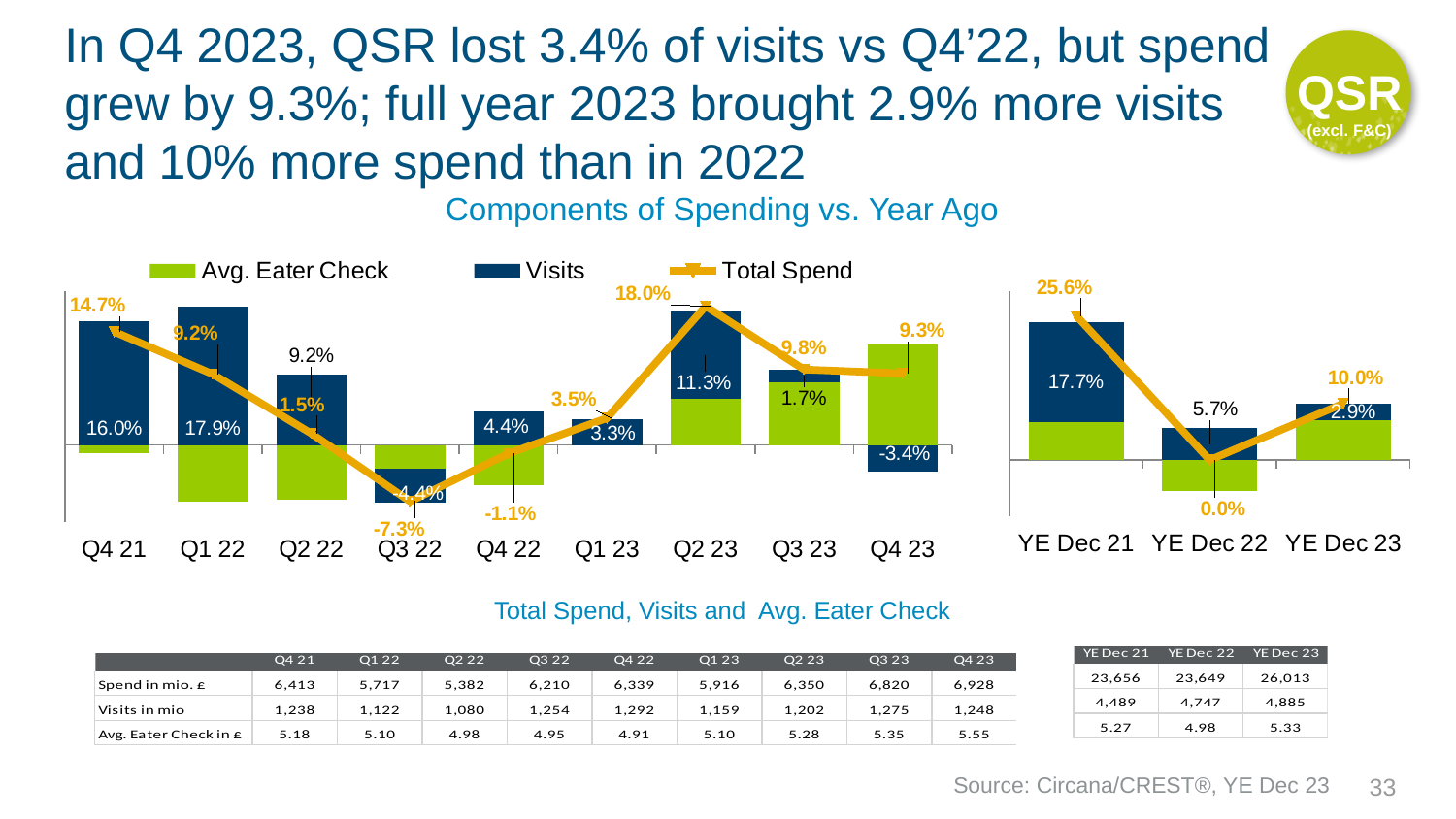
In the quarterly chart on the left, what is the difference between the Total Spend values for Q2 23 and Q3 23? 8.2 percentage points How many series does the legend of the Components of Spending vs. Year Ago chart list? 3 In the yearly chart on the right, what is the Total Spend value for YE Dec 21? 25.6% In the quarterly chart on the left, does the Total Spend line rise or fall from Q3 22 to Q2 23? Rise How many quarters are shown on the x axis of the quarterly chart on the left? 9 In the quarterly chart on the left, which quarter has the larger Visits value, Q4 21 or Q1 22? Q1 22 What kind of chart is the Components of Spending vs. Year Ago chart? Stacked bar chart with a line overlay In the quarterly chart on the left, what is the Visits value for Q4 23? -3.4% In the quarterly chart on the left, which quarter has the highest Total Spend value? Q2 23 In the quarterly chart on the left, which quarter has the lowest Total Spend value? Q3 22 In the yearly chart on the right, what is the Visits value for YE Dec 22? 5.7% In the quarterly chart on the left, what is the Total Spend value for Q2 23? 18.0%